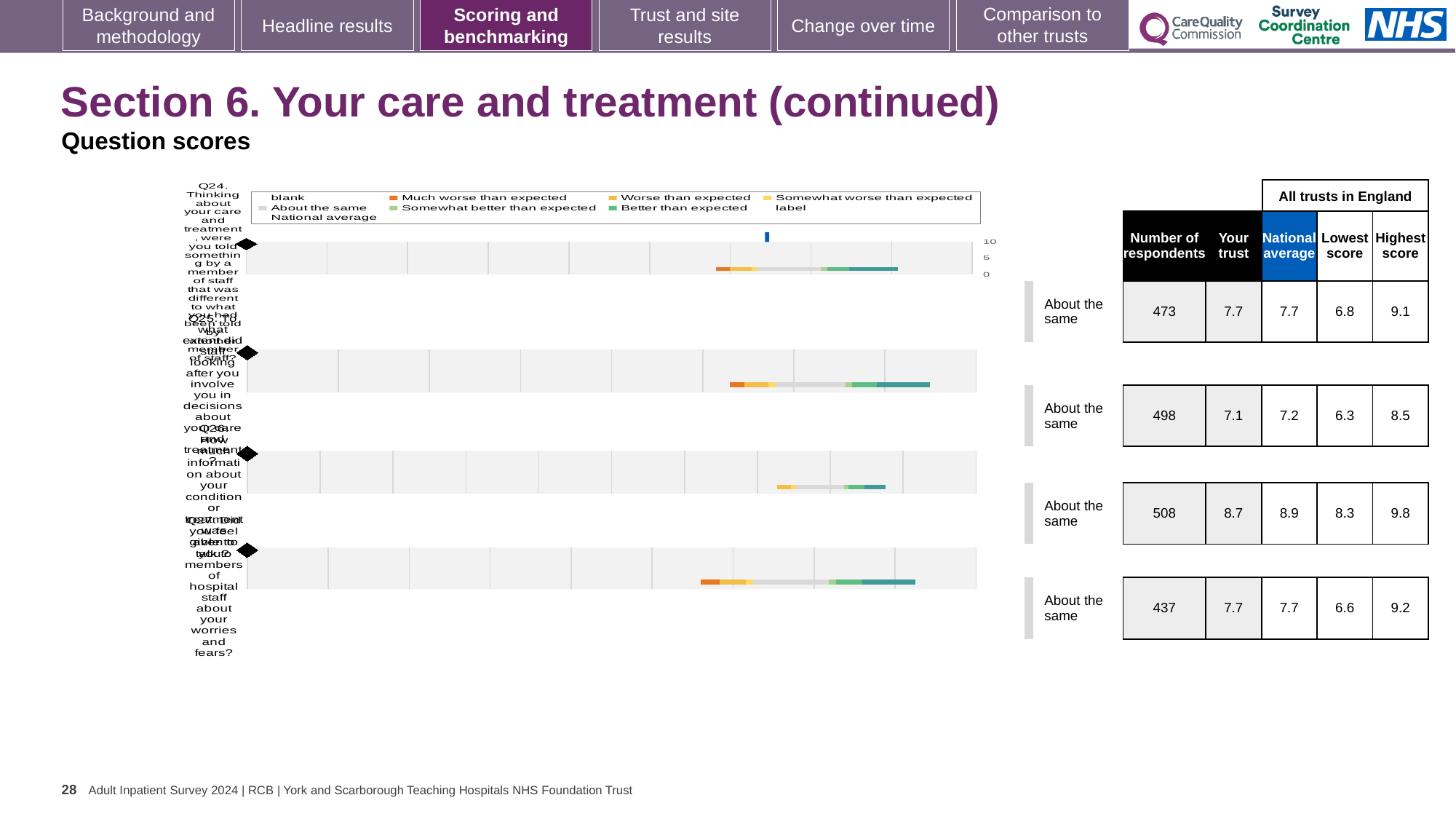
Which question (Q24, Q25, Q26 or Q27) has the highest 'Your trust' score? Q26 For Q25 (the second chart), what is the national average score? 7.2 For Q27 (the bottom chart), what is the highest score among all trusts in England? 9.2 What benchmark category is shown next to each of the four charts? About the same How many question charts (Q24 to Q27) are shown on the slide? 4 Is the 'Your trust' score for Q26 larger or smaller than the national average for Q26? smaller For Q26 (the third chart), how many respondents are listed? 508 What kind of chart is used for the question scores on this slide? bar chart In the chart legend, what colour represents 'Much worse than expected'? orange What is the difference between the highest score and the lowest score for Q25? 2.2 Which question (Q24, Q25, Q26 or Q27) has the lowest number of respondents? Q27 For Q24 (the top chart), what is the 'Your trust' score shown in the table? 7.7